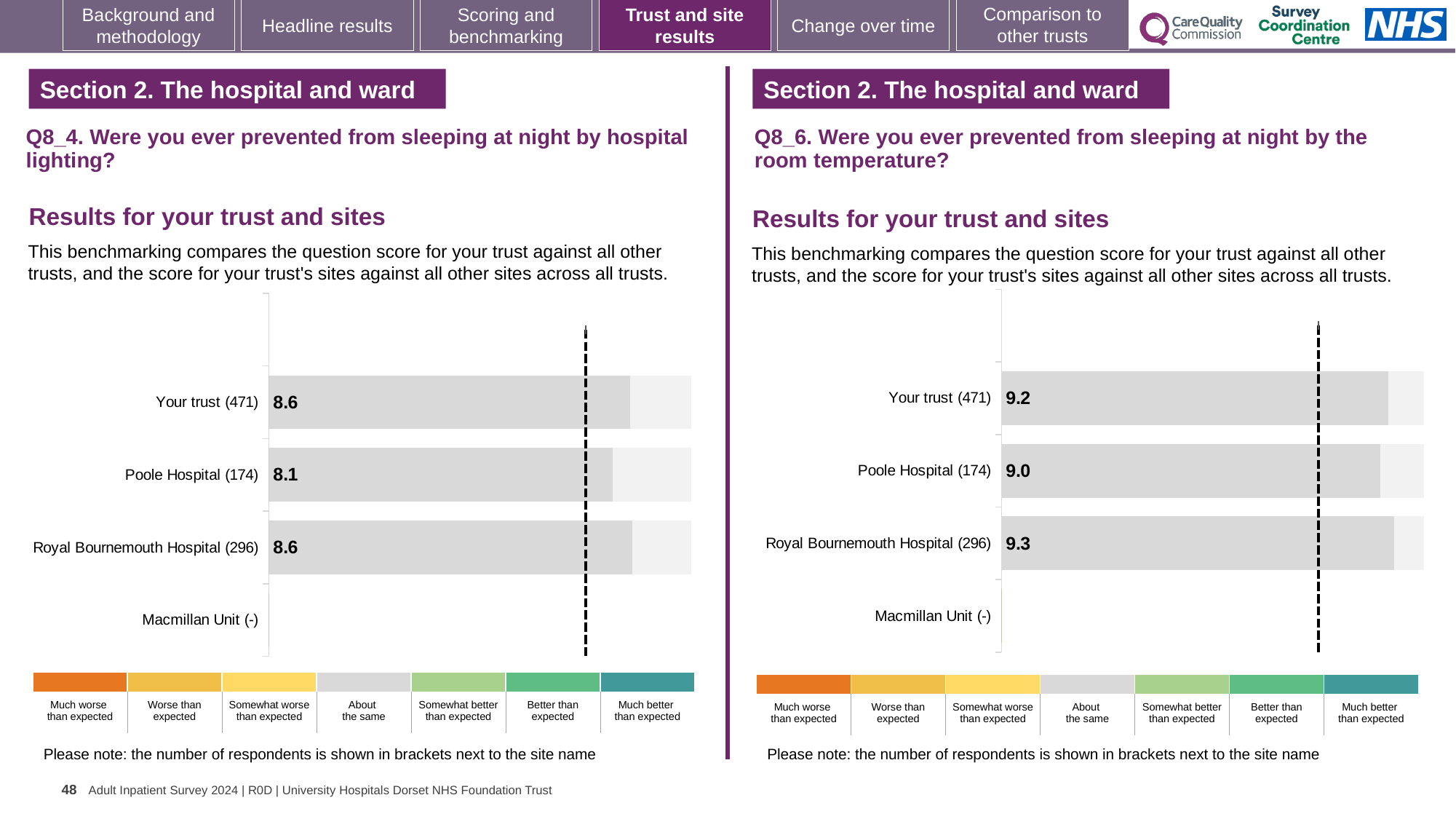
In the Q8_6 chart (room temperature), what is the difference between the scores for Your trust and Poole Hospital? 0.2 How many sites (including Your trust) are listed on the Q8_4 chart (hospital lighting)? 4 In the Q8_4 chart (hospital lighting), which site has the lowest score? Poole Hospital In the Q8_4 chart (hospital lighting), what is the score for Poole Hospital? 8.1 In the Q8_6 chart (room temperature), which site has the highest score? Royal Bournemouth Hospital What kind of chart is used for the Q8_6 results (room temperature)? Bar chart In the Q8_4 chart (hospital lighting), what is the score for Your trust? 8.6 In the Q8_6 chart (room temperature), which has the larger score, Your trust or Poole Hospital? Your trust In the Q8_4 chart (hospital lighting), how many respondents are shown in brackets for Royal Bournemouth Hospital? 296 In the Q8_6 chart (room temperature), what is the score for Royal Bournemouth Hospital? 9.3 In the Q8_6 chart (room temperature), what is the score for Poole Hospital? 9.0 In the Q8_4 chart (hospital lighting), what is the difference between the scores for Royal Bournemouth Hospital and Poole Hospital? 0.5